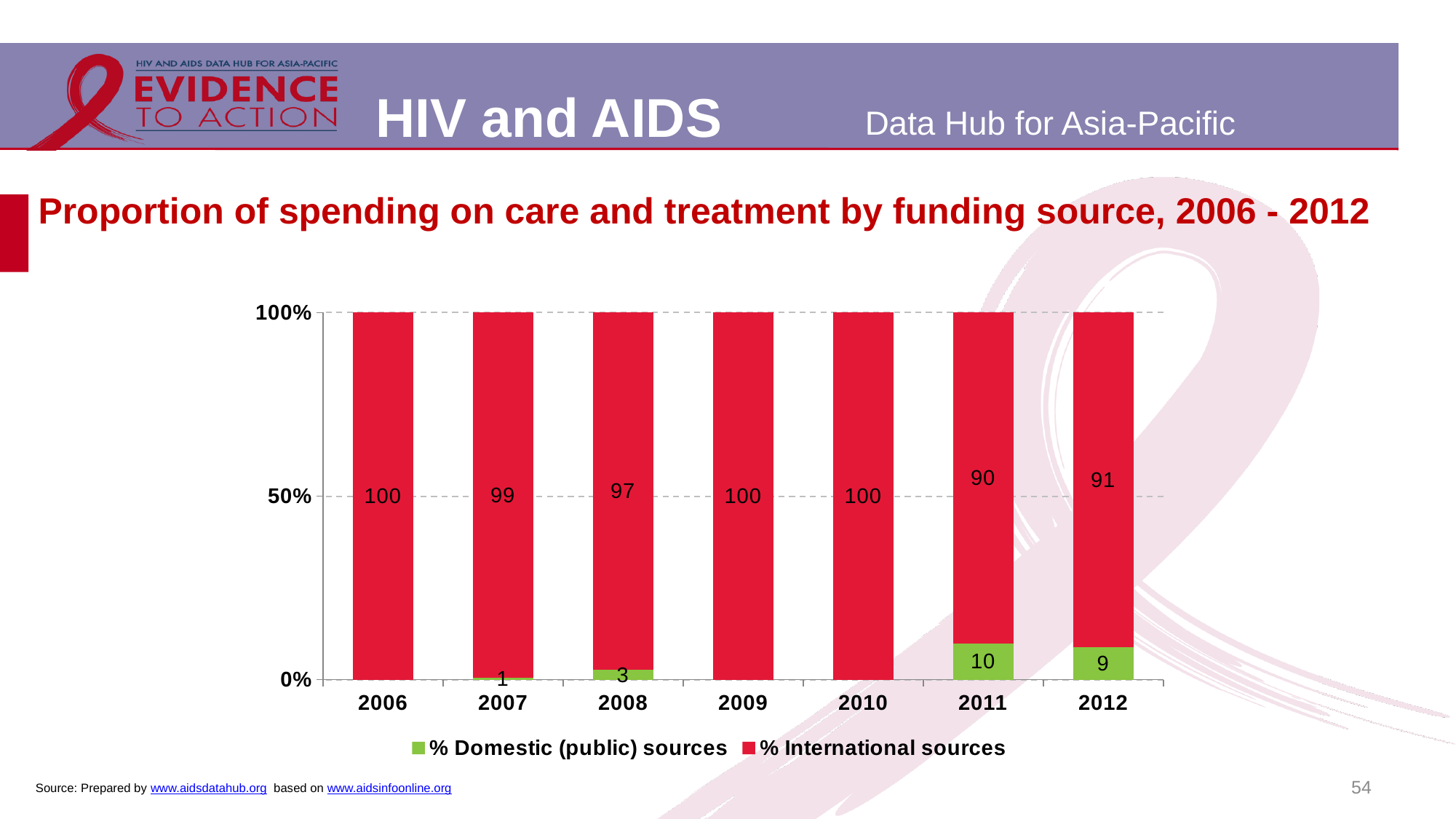
Which is larger, the % Domestic (public) sources value for 2008 or for 2012? 2012 What is the difference between the % International sources values for 2006 and 2011? 10 How many series does the legend list? 2 Which colour represents % International sources in the chart? Red What is the value for % Domestic (public) sources in 2011? 10 What is the value for % Domestic (public) sources in 2012? 9 What is the value for % International sources in 2007? 99 What is the value for % International sources in 2008? 97 How many years are shown on the x axis? 7 Which year has the highest value for % Domestic (public) sources? 2011 What kind of chart is shown on the slide? Stacked bar chart Which year has the lowest value for % International sources? 2011